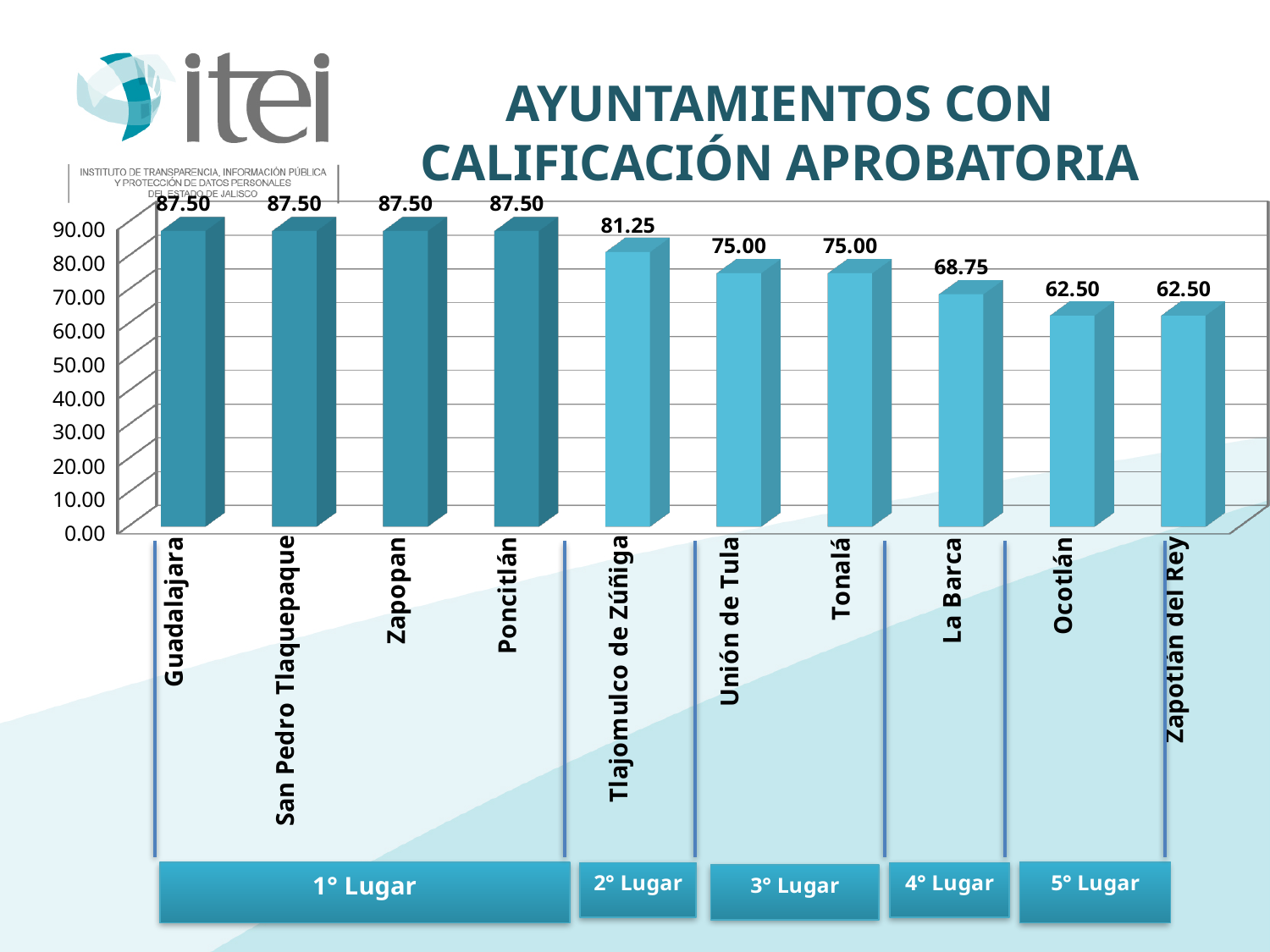
Do the values rise or fall from left to right along the x axis? Fall What kind of chart is shown on the slide? Bar chart What is the value for Zapotlán del Rey? 62.50 What is the value for Unión de Tula? 75.00 What is the value for Tlajomulco de Zúñiga? 81.25 Which has a larger value, Zapopan or La Barca? Zapopan What is the highest value shown in the chart? 87.50 What is the value for La Barca? 68.75 How many municipalities (categories) are shown in the chart? 10 What is the lowest value shown in the chart? 62.50 What is the difference between the values for Guadalajara and Ocotlán? 25.00 What is the difference between the values for Tlajomulco de Zúñiga and Tonalá? 6.25